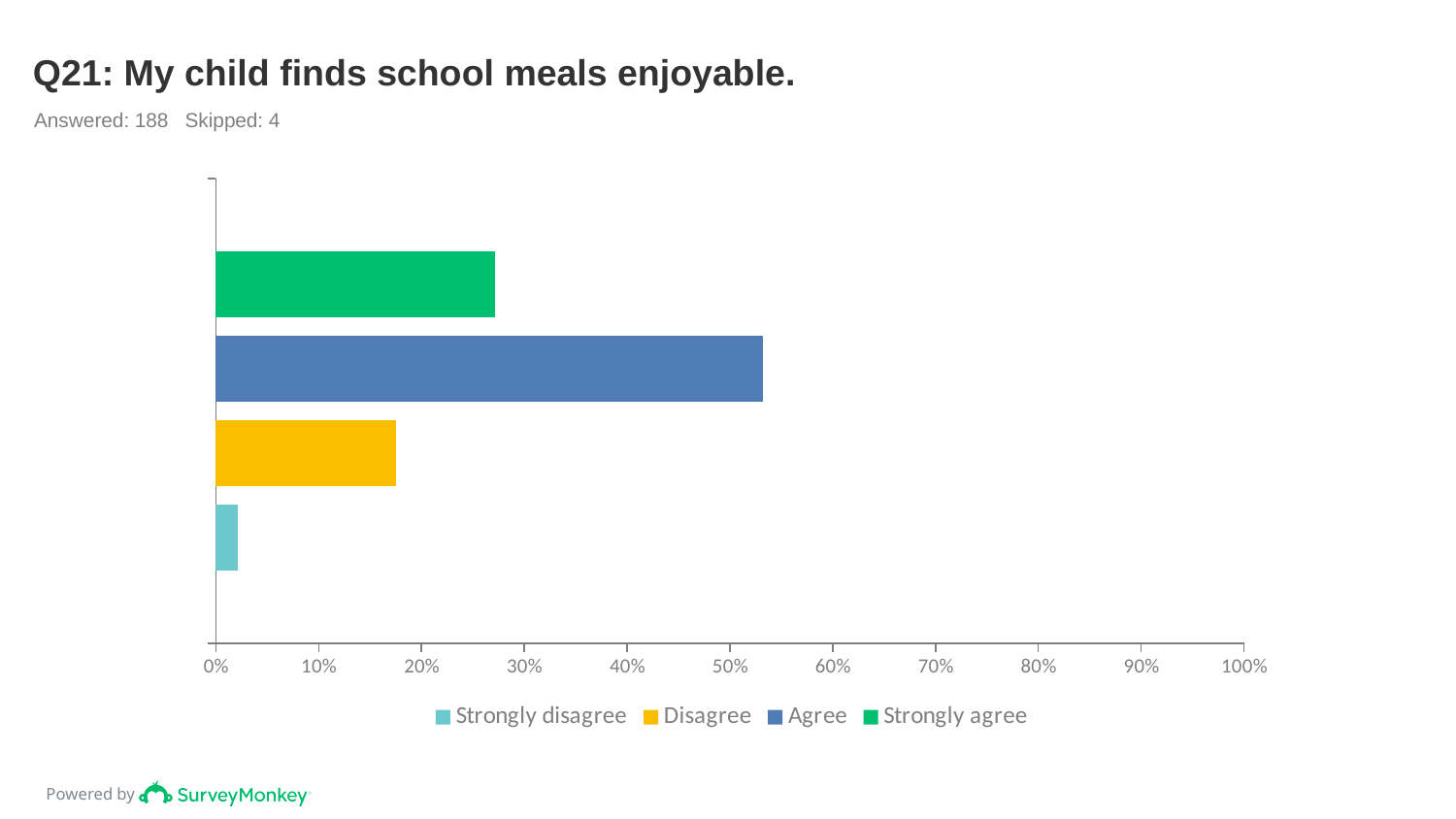
Is the value for Strongly disagree greater or less than 10%? less Which response category has the longest bar? Agree Which response category has the shortest bar? Strongly disagree What is the title of the chart? Q21: My child finds school meals enjoyable. Which is larger, the value for Agree or the value for Strongly agree? Agree How many respondents answered this question according to the slide? 188 Is the value for Strongly agree greater or less than 30%? less Is the value for Agree greater or less than 50%? greater What kind of chart is shown on the slide? bar chart How many series does the legend list? 4 Which is larger, the value for Disagree or the value for Strongly agree? Strongly agree